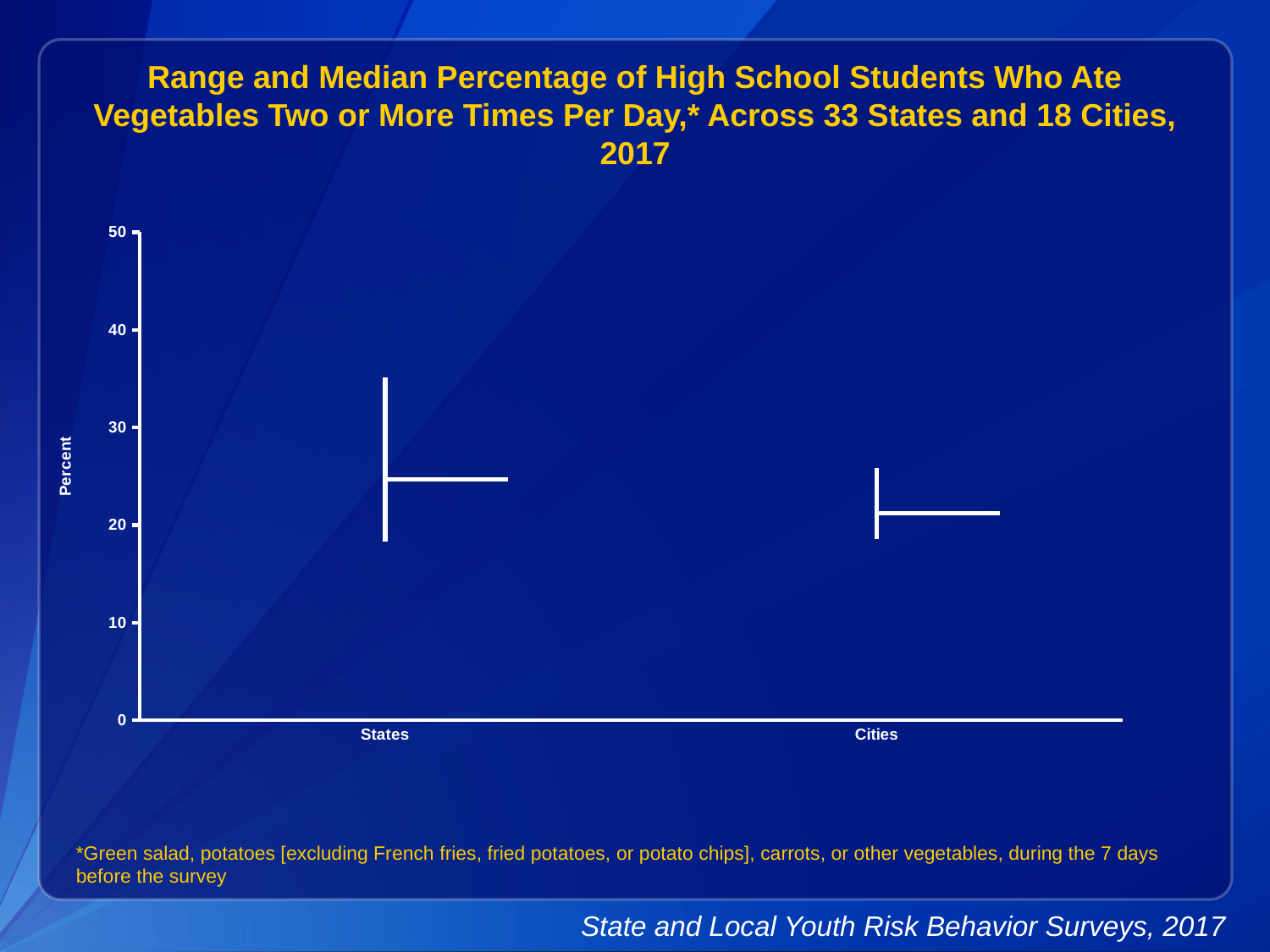
What are the two categories shown on the x axis? States and Cities Which category has the wider range of values, States or Cities? States Which category has the highest median value? States Which category has the lowest median value? Cities Is the median value for States greater or less than 20? greater Is the top of the range for Cities greater or less than 30? less How many categories are shown on the x axis of the chart? 2 Is the top of the range for States greater or less than 30? greater Which category has the higher median percentage, States or Cities? States What is the label of the y axis? Percent